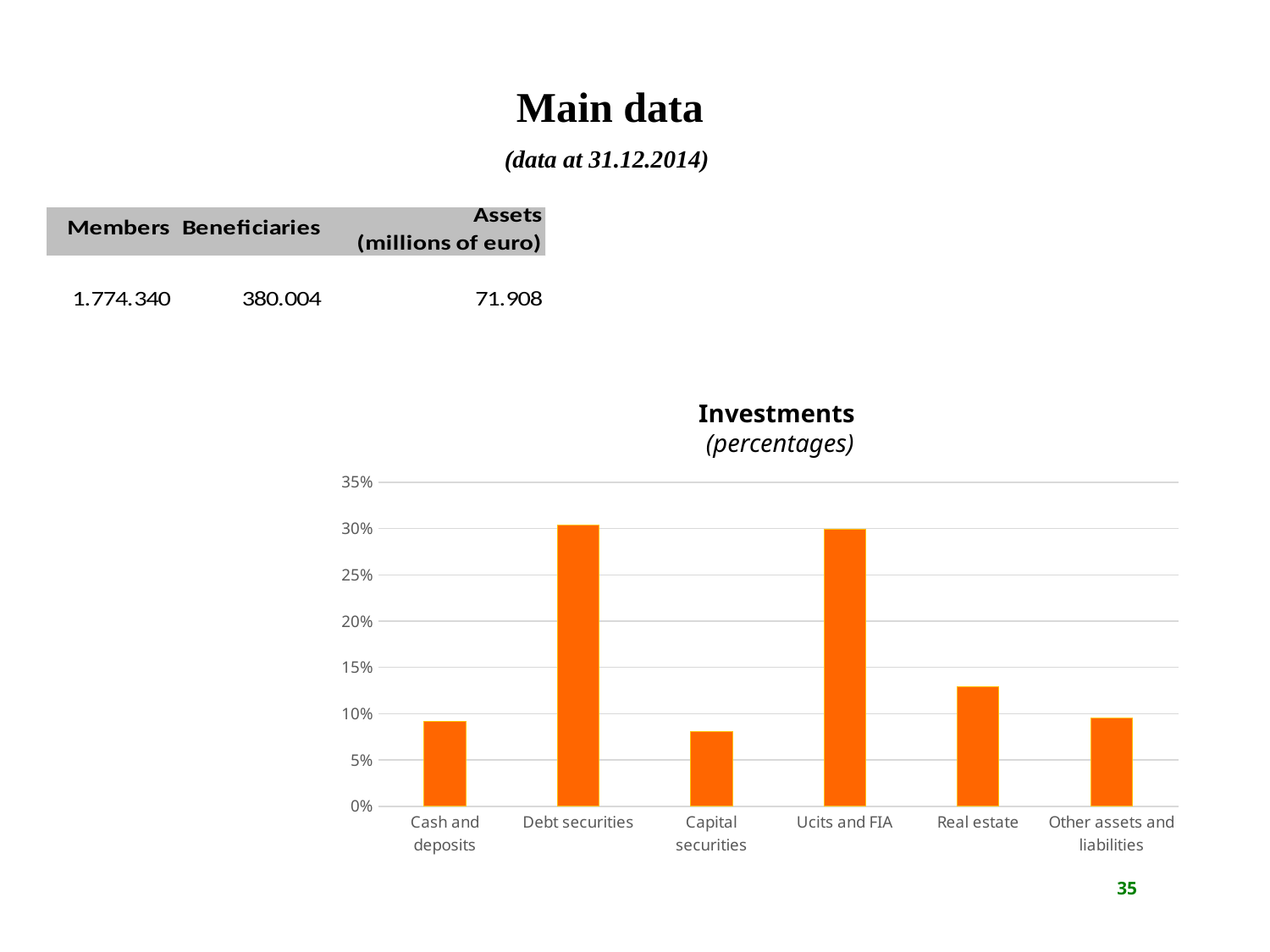
Is the value for Real estate greater or less than 10%? greater Is the value for Ucits and FIA greater or less than 25%? greater What is the title of the chart on the slide? Investments Is the value for Real estate greater or less than 15%? less Which is larger, the value for Debt securities or the value for Other assets and liabilities? Debt securities What kind of chart is shown on the slide? bar chart What colour are the bars in the Investments chart? orange How many categories are shown on the x axis of the Investments chart? 6 Which is larger, the value for Real estate or the value for Cash and deposits? Real estate